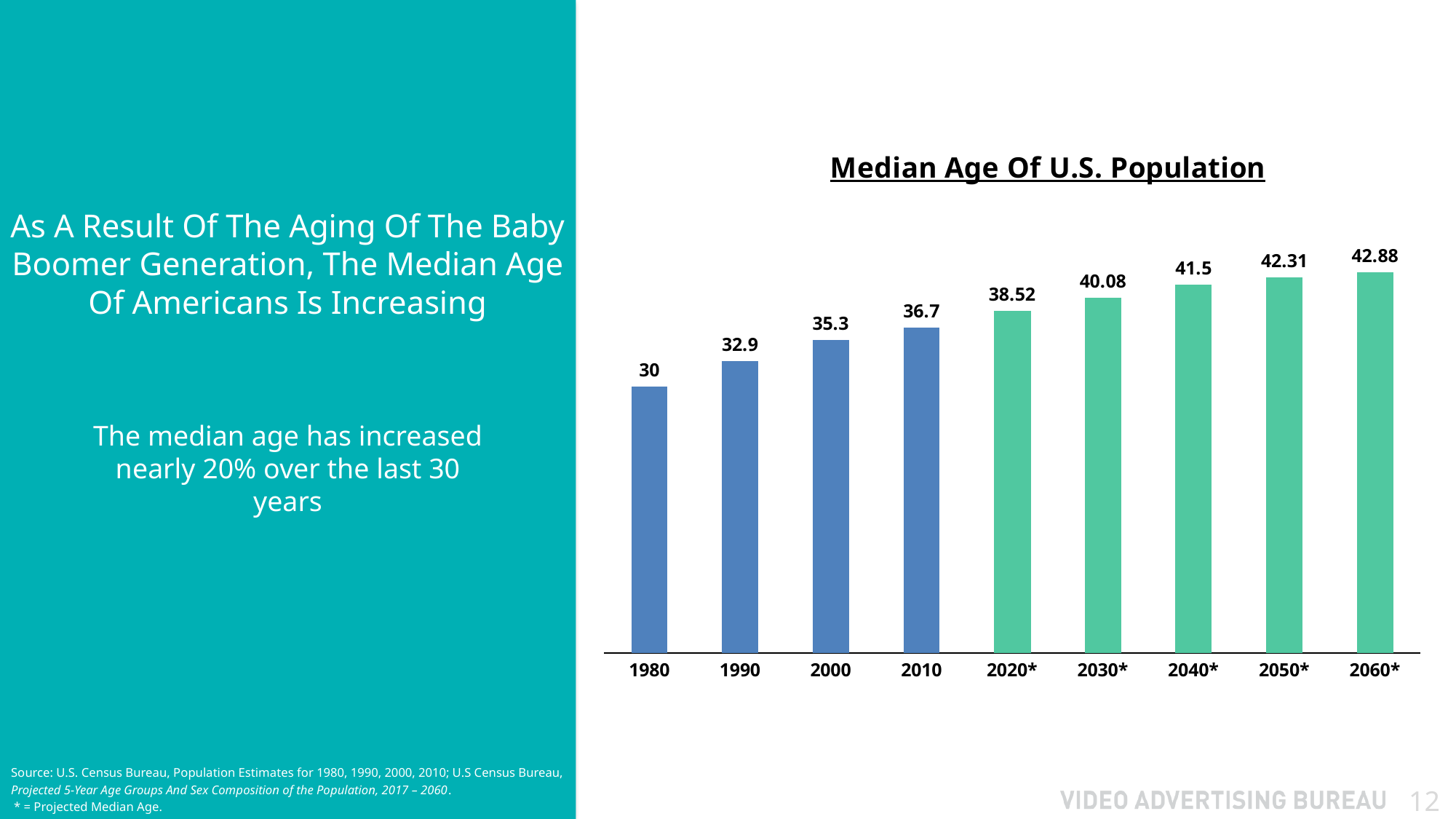
What is the title of the chart? Median Age Of U.S. Population What is the projected median age shown for 2040*? 41.5 Do the median age values rise or fall from 1980 to 2060*? Rise Which year has the lowest median age on the chart? 1980 What is the difference between the median age in 2010 and in 1980? 6.7 Which is larger, the median age in 2000 or in 1990? 2000 What kind of chart is shown on the slide? Bar chart Which year has the highest median age on the chart? 2060* What is the difference between the projected median age in 2060* and in 2020*? 4.36 What is the median age shown for 2010? 36.7 What is the median age of the U.S. population shown for 1980? 30 How many years are shown on the x axis of the chart? 9